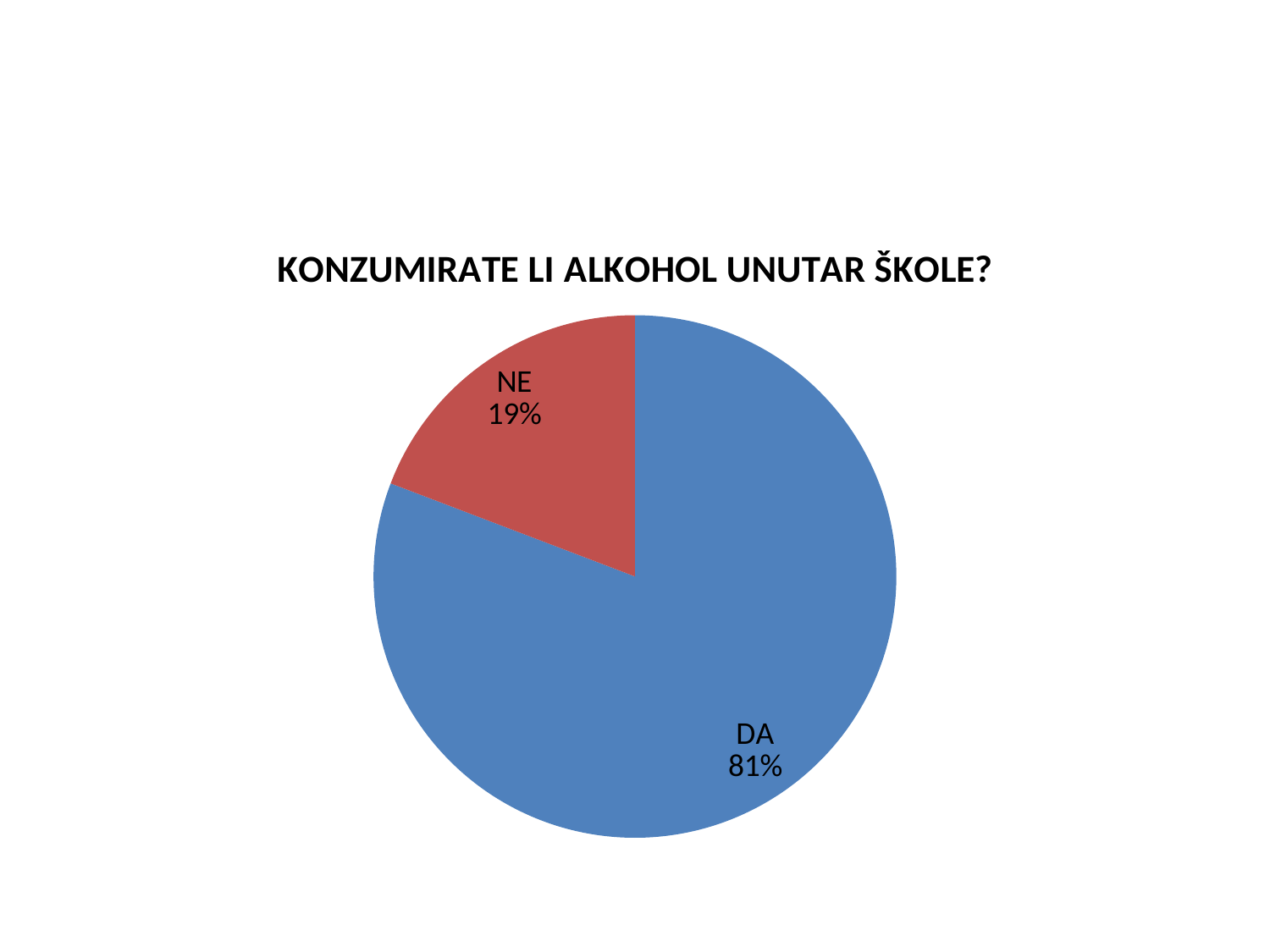
How many slices does the pie chart have? 2 What share of the pie does the NE slice represent? 19% Which is larger, the DA slice or the NE slice? DA What is the title of the chart? KONZUMIRATE LI ALKOHOL UNUTAR ŠKOLE? Which slice is the smallest? NE What share of the pie does the DA slice represent? 81% What is the total of the two slice percentages shown? 100% Which slice is the largest? DA What kind of chart is shown on the slide? pie chart What is the difference in percentage points between the DA and NE slices? 62 What colour is the DA slice? blue